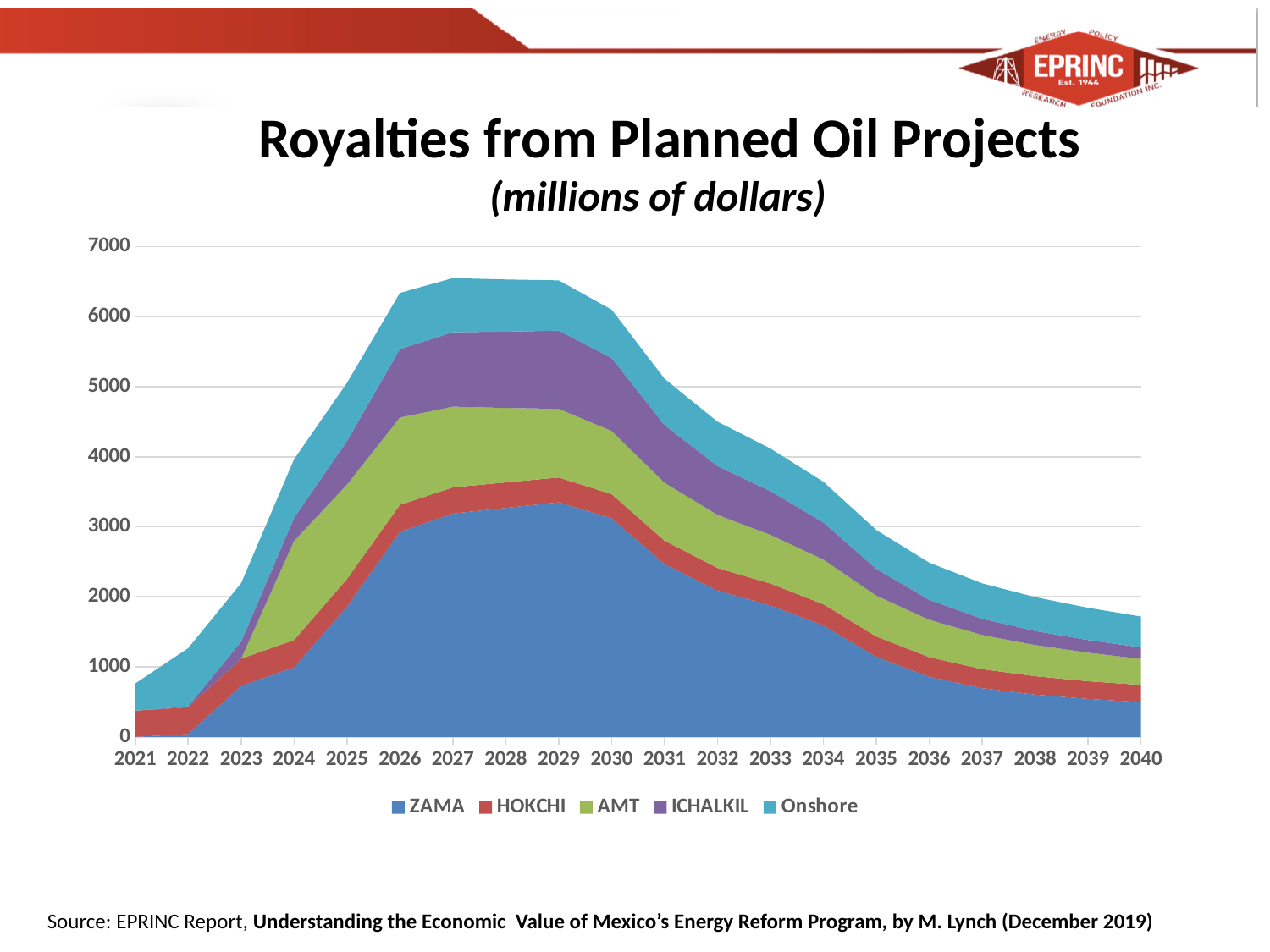
Is the value for ZAMA in 2029 greater or less than 3000? greater What kind of chart is shown on the slide? stacked area chart Is the total value for 2040 greater or less than 2000? less What is the title of the chart? Royalties from Planned Oil Projects (millions of dollars) Is the total value for 2021 greater or less than 1000? less Which series is shown in blue at the bottom of the stack? ZAMA Do total royalties rise or fall from 2021 to 2027? rise How many series does the legend list? 5 Do total royalties rise or fall from 2029 to 2040? fall How many years are shown along the x axis? 20 Which year has the lowest total royalties? 2021